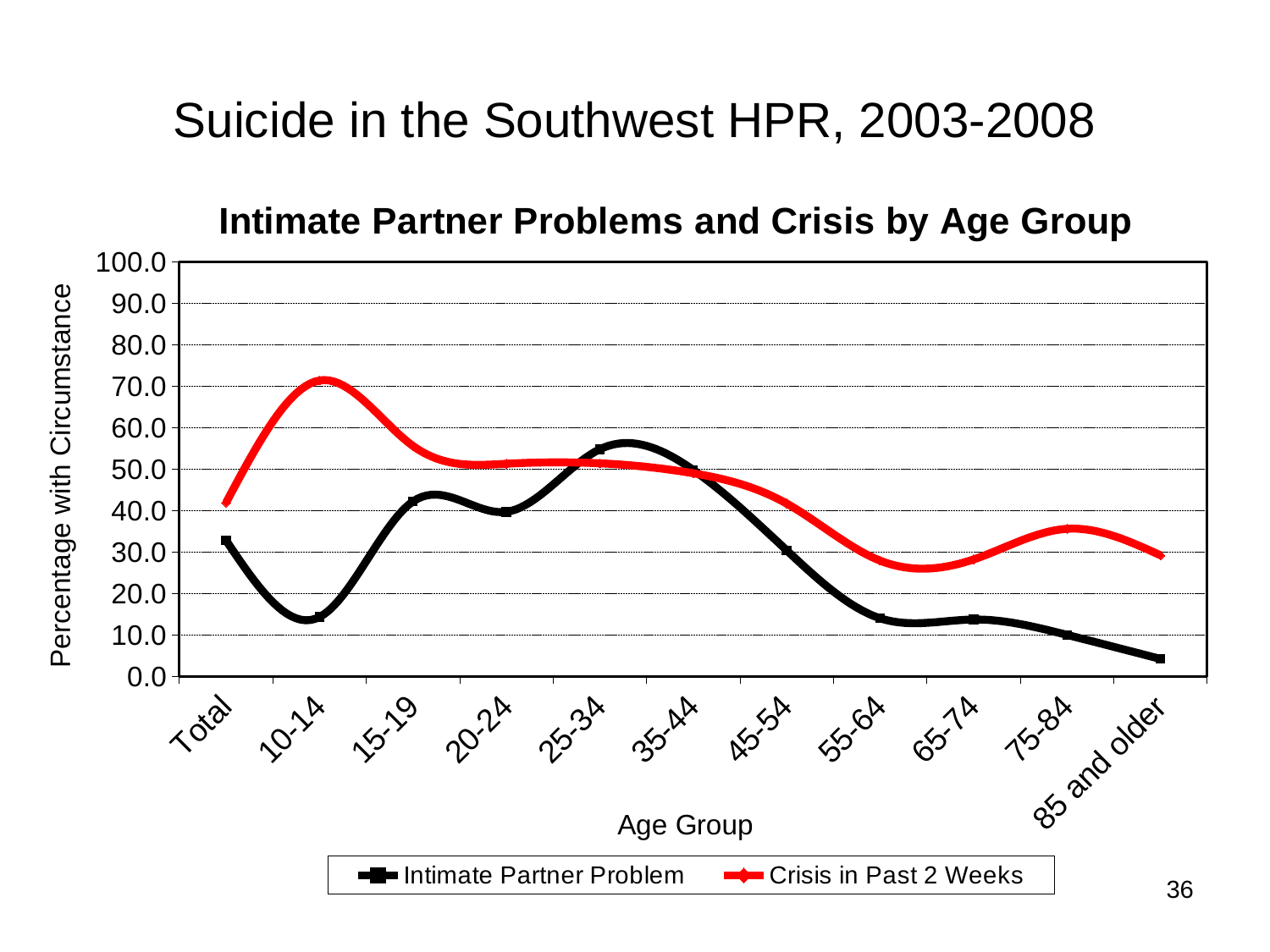
How many age group categories are plotted along the x axis? 11 Is the value for Intimate Partner Problem in the 85 and older age group greater or less than 10.0? less What kind of chart is shown on the slide? Line chart For the 55-64 age group, which series has the larger value: Intimate Partner Problem or Crisis in Past 2 Weeks? Crisis in Past 2 Weeks Does the Intimate Partner Problem line rise or fall from the 45-54 age group to the 85 and older age group? Fall Is the value for Crisis in Past 2 Weeks in the 10-14 age group greater or less than 60.0? greater Which age group has the lowest value for Intimate Partner Problem? 85 and older What is the label on the y axis of the chart? Percentage with Circumstance Which age group has the highest value for Crisis in Past 2 Weeks? 10-14 For the 10-14 age group, which series has the larger value: Intimate Partner Problem or Crisis in Past 2 Weeks? Crisis in Past 2 Weeks Which age group has the highest value for Intimate Partner Problem? 25-34 How many series does the legend list? 2